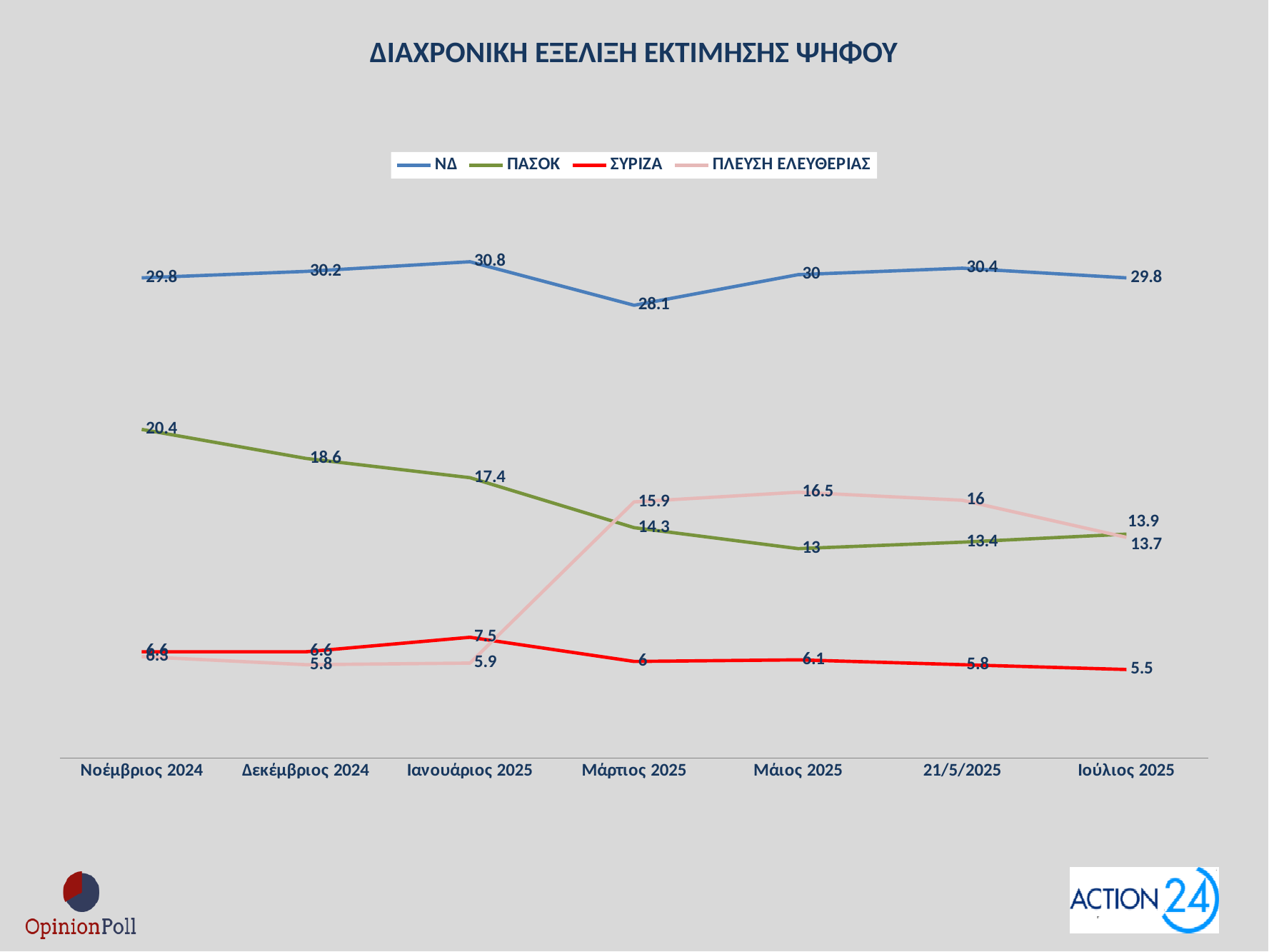
At which time point is the ΠΑΣΟΚ value lowest? Μάιος 2025 In Μάρτιος 2025, which is larger: ΠΑΣΟΚ or ΠΛΕΥΣΗ ΕΛΕΥΘΕΡΙΑΣ? ΠΛΕΥΣΗ ΕΛΕΥΘΕΡΙΑΣ At which time point is the ΝΔ value highest? Ιανουάριος 2025 At which time point is the ΝΔ value lowest? Μάρτιος 2025 What is the difference between the ΠΑΣΟΚ values in Νοέμβριος 2024 and Δεκέμβριος 2024? 1.8 How many series does the legend list? 4 What is the value for ΠΛΕΥΣΗ ΕΛΕΥΘΕΡΙΑΣ in Μάιος 2025? 16.5 How many time points are shown on the x axis? 7 What is the value for ΝΔ in Μάρτιος 2025? 28.1 What is the value for ΠΑΣΟΚ in Νοέμβριος 2024? 20.4 What kind of chart is shown on the slide? Line chart What is the value for ΣΥΡΙΖΑ in Ιανουάριος 2025? 7.5